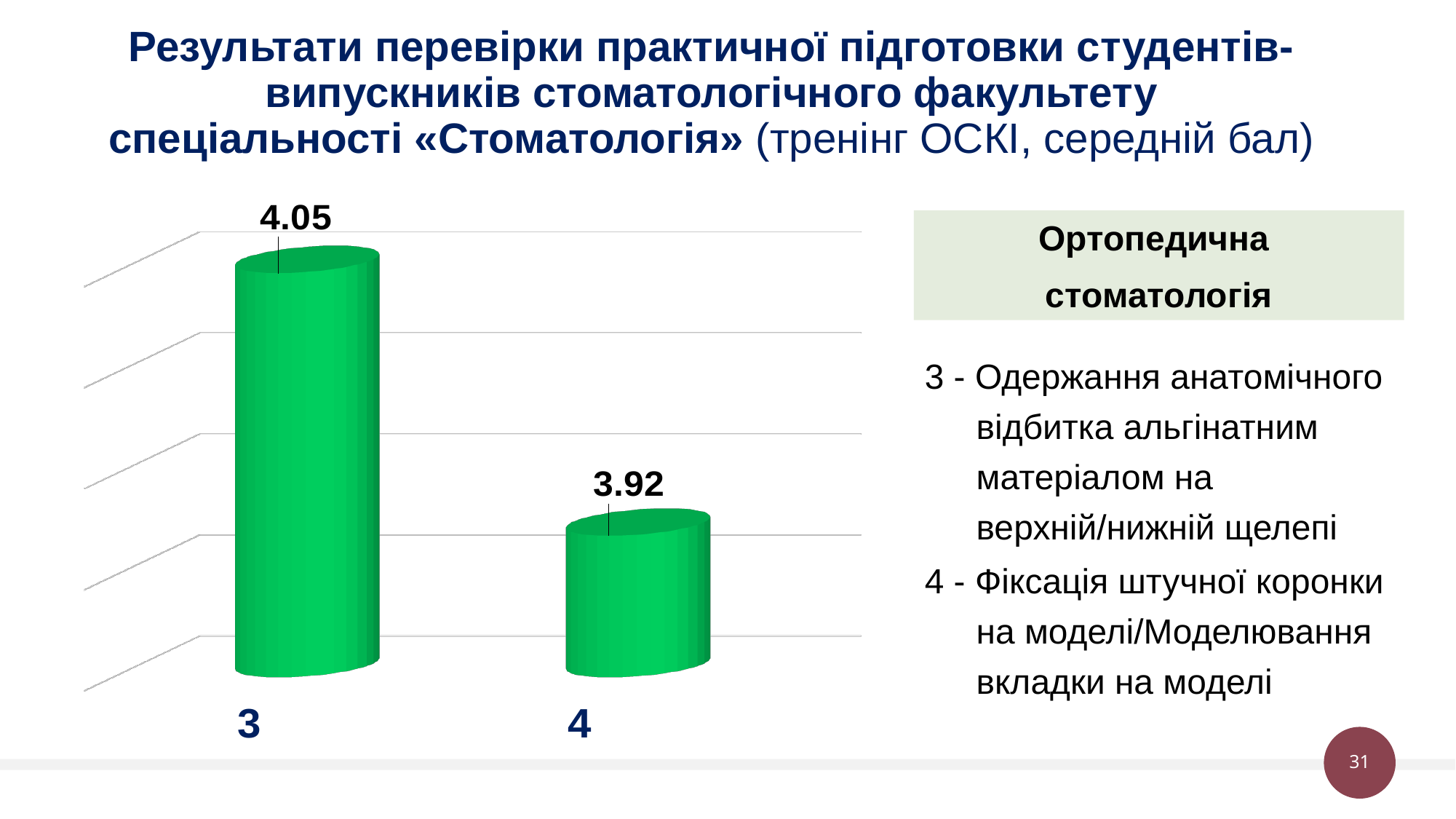
How many categories are shown in the chart? 2 Which section of dentistry does the chart refer to, according to the heading next to it? Ортопедична стоматологія Which is larger, the value for category 3 or category 4? 3 What is the value for category 3? 4.05 Do the values rise or fall from category 3 to category 4? fall Which category has the lowest value? 4 What is the value for category 4? 3.92 What is the difference between the values for category 3 and category 4? 0.13 Which category has the highest value? 3 What colour are the bars in the chart? green What kind of chart is shown on the slide? bar chart